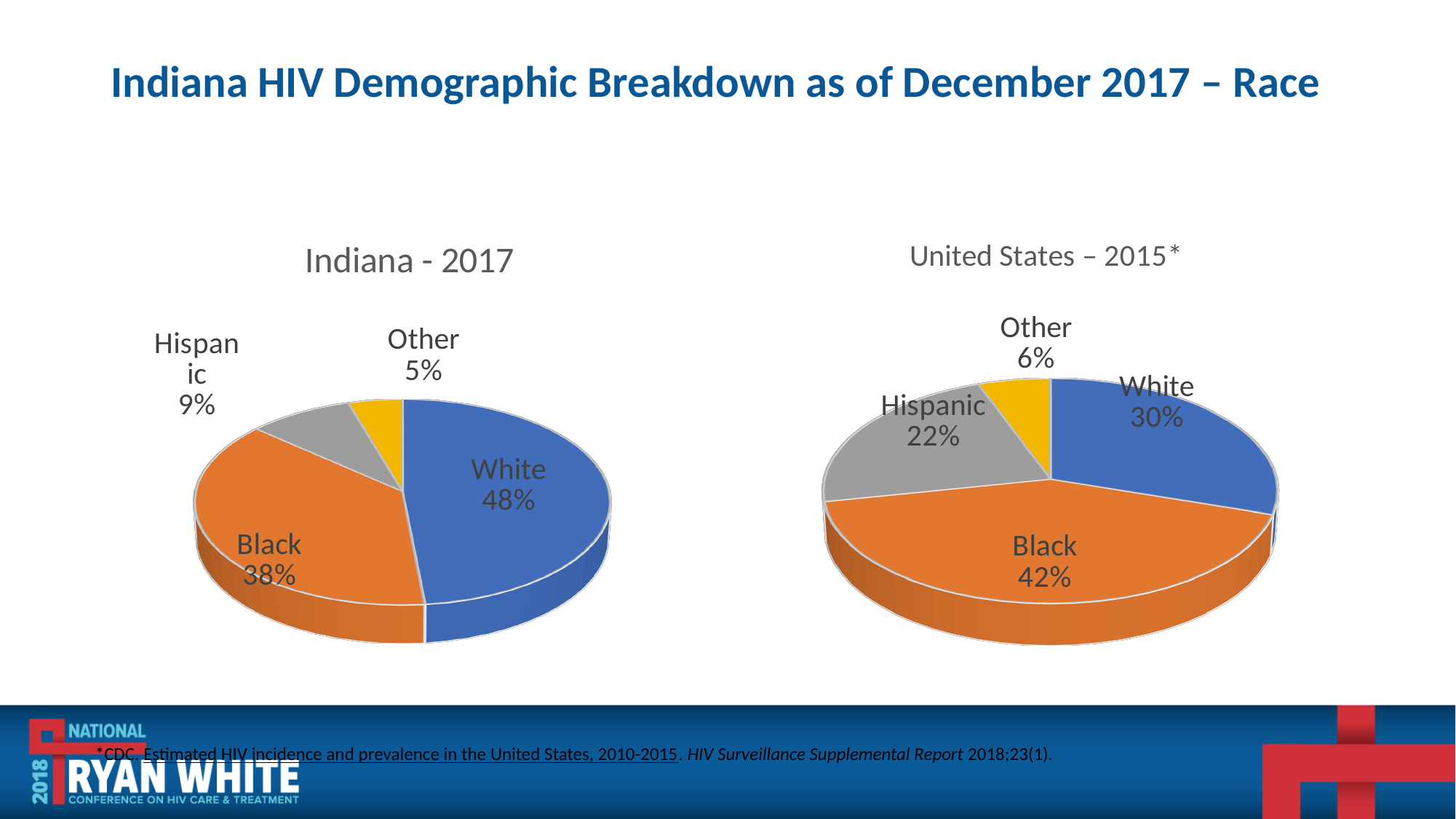
In the 'Indiana - 2017' chart, what percentage is shown for White? 48% What type of chart is the 'United States – 2015*' chart? Pie chart In the 'United States – 2015*' chart, which category has the largest share? Black In the 'United States – 2015*' chart, what percentage is shown for Hispanic? 22% In the 'Indiana - 2017' chart, which category has the largest share? White In the 'Indiana - 2017' chart, what is the difference between the White and Black percentages? 10% In the 'United States – 2015*' chart, which is larger, the Hispanic share or the White share? White How many categories does the 'Indiana - 2017' chart show? 4 In the 'United States – 2015*' chart, what percentage is shown for Other? 6% In the 'United States – 2015*' chart, what is the difference between the Black and White percentages? 12% In the 'Indiana - 2017' chart, what percentage is shown for Black? 38% In the 'Indiana - 2017' chart, which category has the smallest share? Other